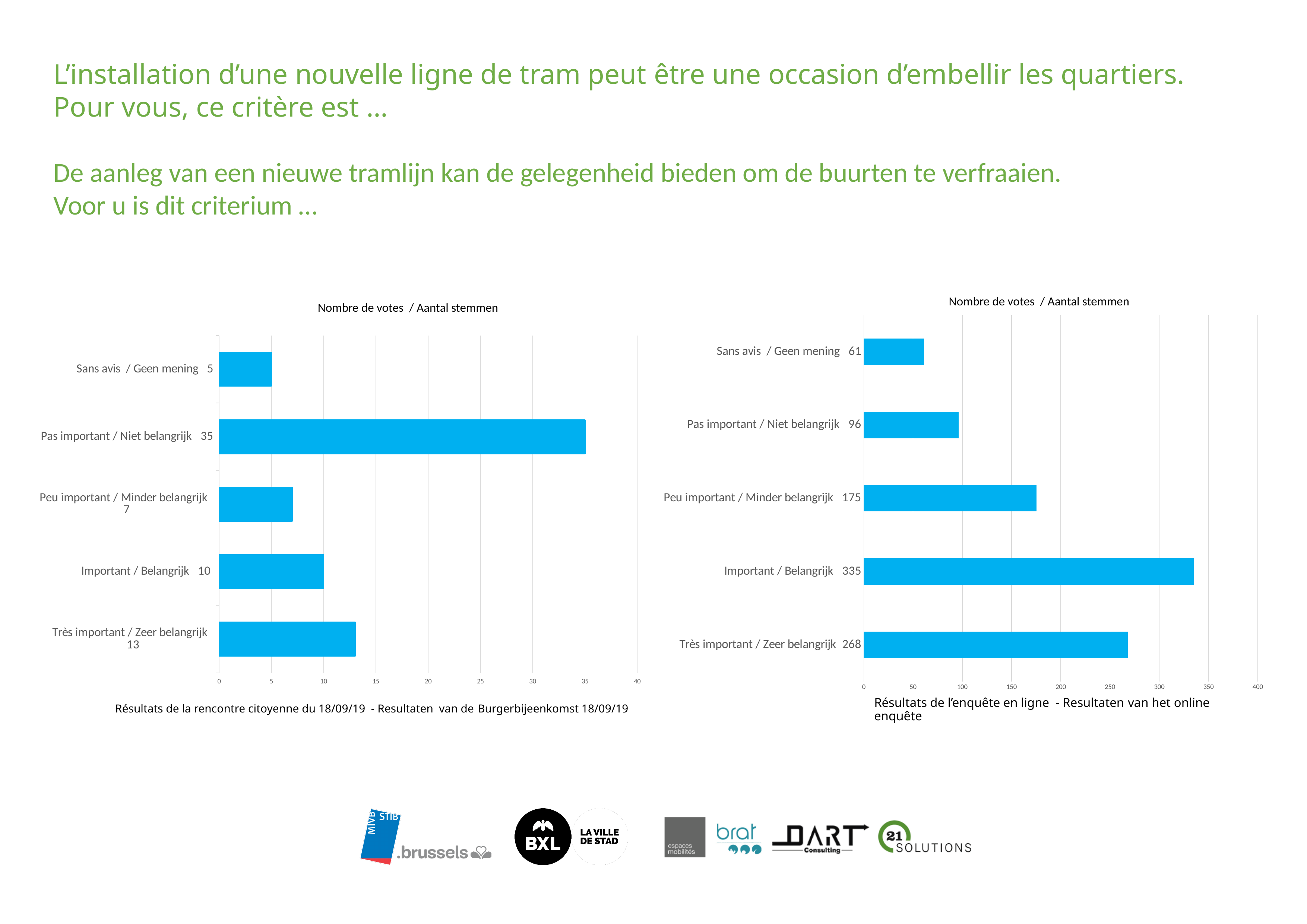
What is the title shown above the left chart? Nombre de votes / Aantal stemmen What type of chart is the right chart (Résultats de l'enquête en ligne)? Bar chart In the left chart (Résultats de la rencontre citoyenne du 18/09/19), which category has the highest number of votes? Pas important / Niet belangrijk In the right chart (Résultats de l'enquête en ligne), how many votes did 'Sans avis / Geen mening' receive? 61 In the left chart (Résultats de la rencontre citoyenne du 18/09/19), how many votes did 'Pas important / Niet belangrijk' receive? 35 In the left chart (Résultats de la rencontre citoyenne du 18/09/19), which has more votes: 'Très important / Zeer belangrijk' or 'Important / Belangrijk'? Très important / Zeer belangrijk In the left chart (Résultats de la rencontre citoyenne du 18/09/19), what is the difference in votes between 'Pas important / Niet belangrijk' and 'Sans avis / Geen mening'? 30 In the right chart (Résultats de l'enquête en ligne), what is the difference in votes between 'Important / Belangrijk' and 'Très important / Zeer belangrijk'? 67 In the right chart (Résultats de l'enquête en ligne), is the value for 'Peu important / Minder belangrijk' greater or less than 150? greater In the right chart (Résultats de l'enquête en ligne), how many votes did 'Important / Belangrijk' receive? 335 How many categories are shown in the left chart (Résultats de la rencontre citoyenne du 18/09/19)? 5 In the right chart (Résultats de l'enquête en ligne), which category has the lowest number of votes? Sans avis / Geen mening